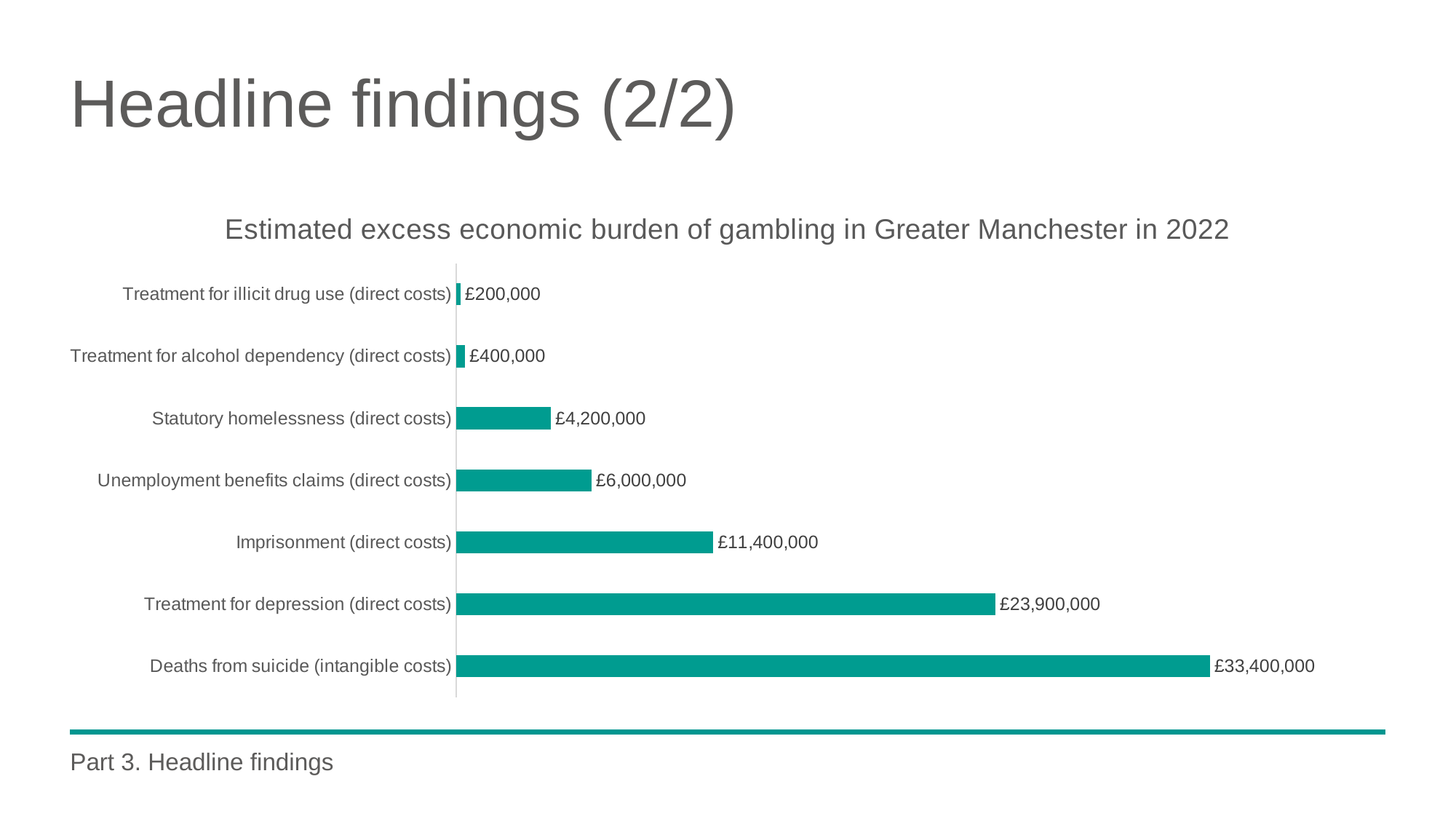
What is the difference between the values for Deaths from suicide (intangible costs) and Treatment for depression (direct costs)? £9,500,000 Which category has the lowest estimated excess economic burden? Treatment for illicit drug use (direct costs) What is the value shown for Statutory homelessness (direct costs)? £4,200,000 What is the estimated excess economic burden for Deaths from suicide (intangible costs)? £33,400,000 Which category has the highest estimated excess economic burden? Deaths from suicide (intangible costs) How many categories are shown in the chart? 7 What is the title of the chart? Estimated excess economic burden of gambling in Greater Manchester in 2022 What kind of chart is shown on the slide? Bar chart What is the value shown for Treatment for alcohol dependency (direct costs)? £400,000 What is the value shown for Imprisonment (direct costs)? £11,400,000 Which is larger: the value for Imprisonment (direct costs) or Unemployment benefits claims (direct costs)? Imprisonment (direct costs) What is the difference between the values for Unemployment benefits claims (direct costs) and Statutory homelessness (direct costs)? £1,800,000